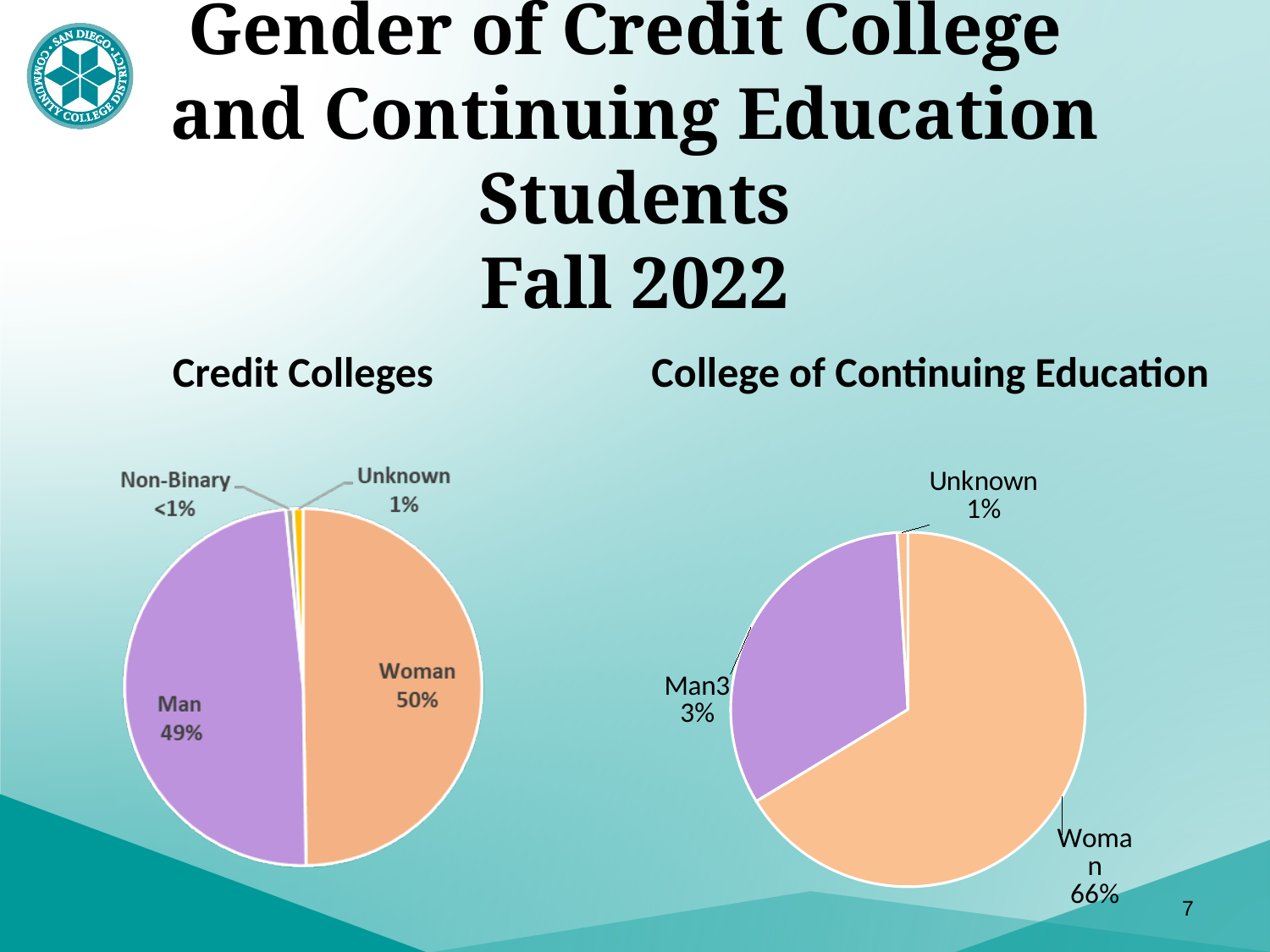
In the Credit Colleges chart, what share of students are women? 50% In the Credit Colleges chart, what is the difference between the Woman and Man shares? 1% In the College of Continuing Education chart, which gender category has the smallest share? Unknown In the College of Continuing Education chart, which gender category has the largest share? Woman In the Credit Colleges chart, what share of students have an unknown gender? 1% In the Credit Colleges chart, what share of students are men? 49% In the College of Continuing Education chart, what share of students have an unknown gender? 1% Which chart shows a larger share of women, Credit Colleges or College of Continuing Education? College of Continuing Education In the Credit Colleges chart, what share is shown for Non-Binary students? <1% In the College of Continuing Education chart, what share of students are women? 66% What type of chart is used on the slide for Credit Colleges? Pie chart In the Credit Colleges chart, how many gender categories are shown? 4